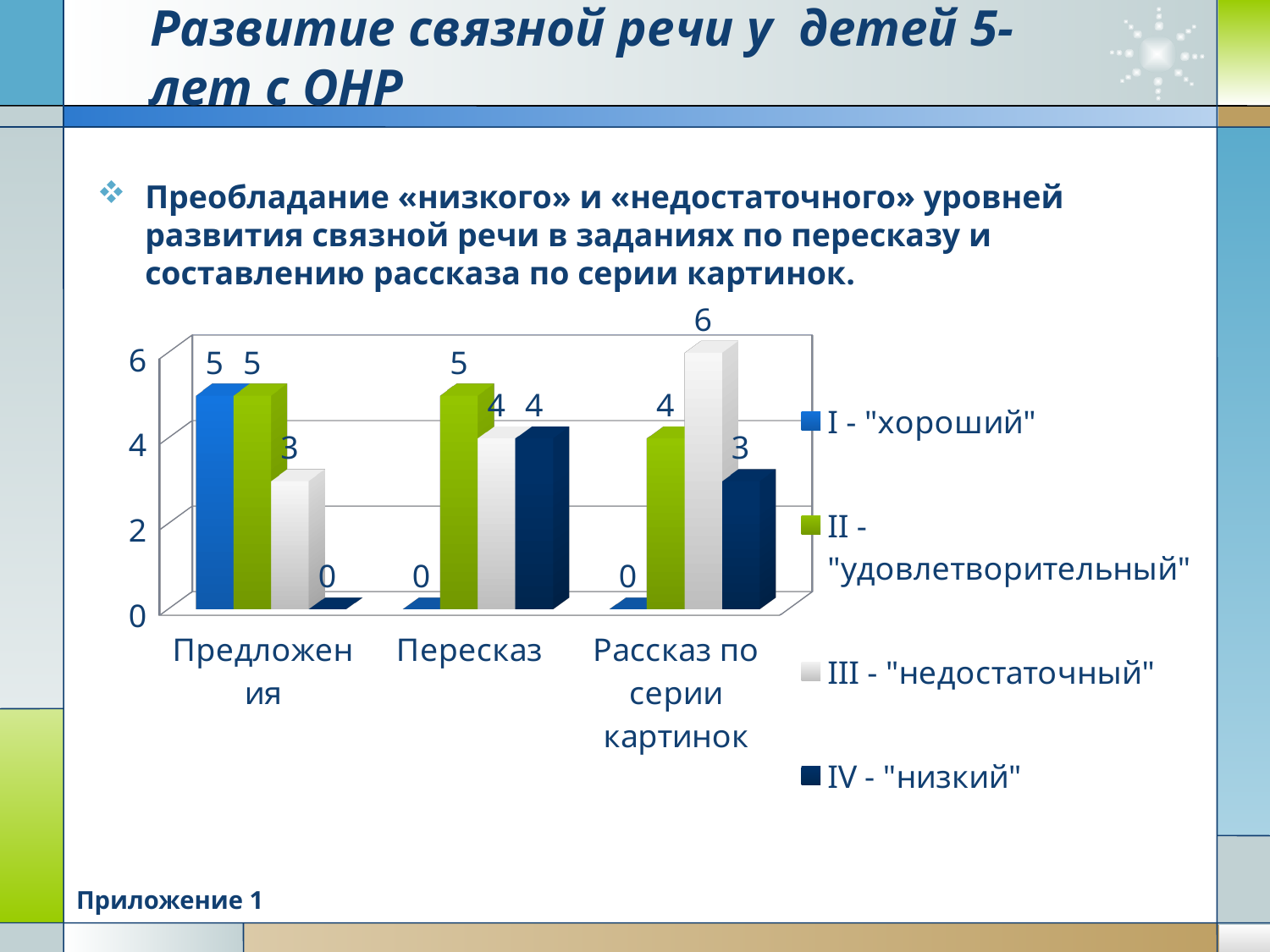
Which is larger: the II - "удовлетворительный" value for Пересказ or the II - "удовлетворительный" value for Рассказ по серии картинок? Пересказ Which series has the highest value in the Рассказ по серии картинок category? III - "недостаточный" What kind of chart is shown on the slide? Bar chart What is the value for IV - "низкий" in the Пересказ category? 4 What is the value for III - "недостаточный" in the Рассказ по серии картинок category? 6 How many categories are shown on the x axis? 3 What is the value for I - "хороший" in the Пересказ category? 0 Which series has the lowest value in the Предложения category? IV - "низкий" What is the difference between the III - "недостаточный" value and the IV - "низкий" value in the Рассказ по серии картинок category? 3 How many series does the legend list? 4 Does the value for I - "хороший" rise or fall from Предложения to Пересказ? Fall What is the value for I - "хороший" in the Предложения category? 5